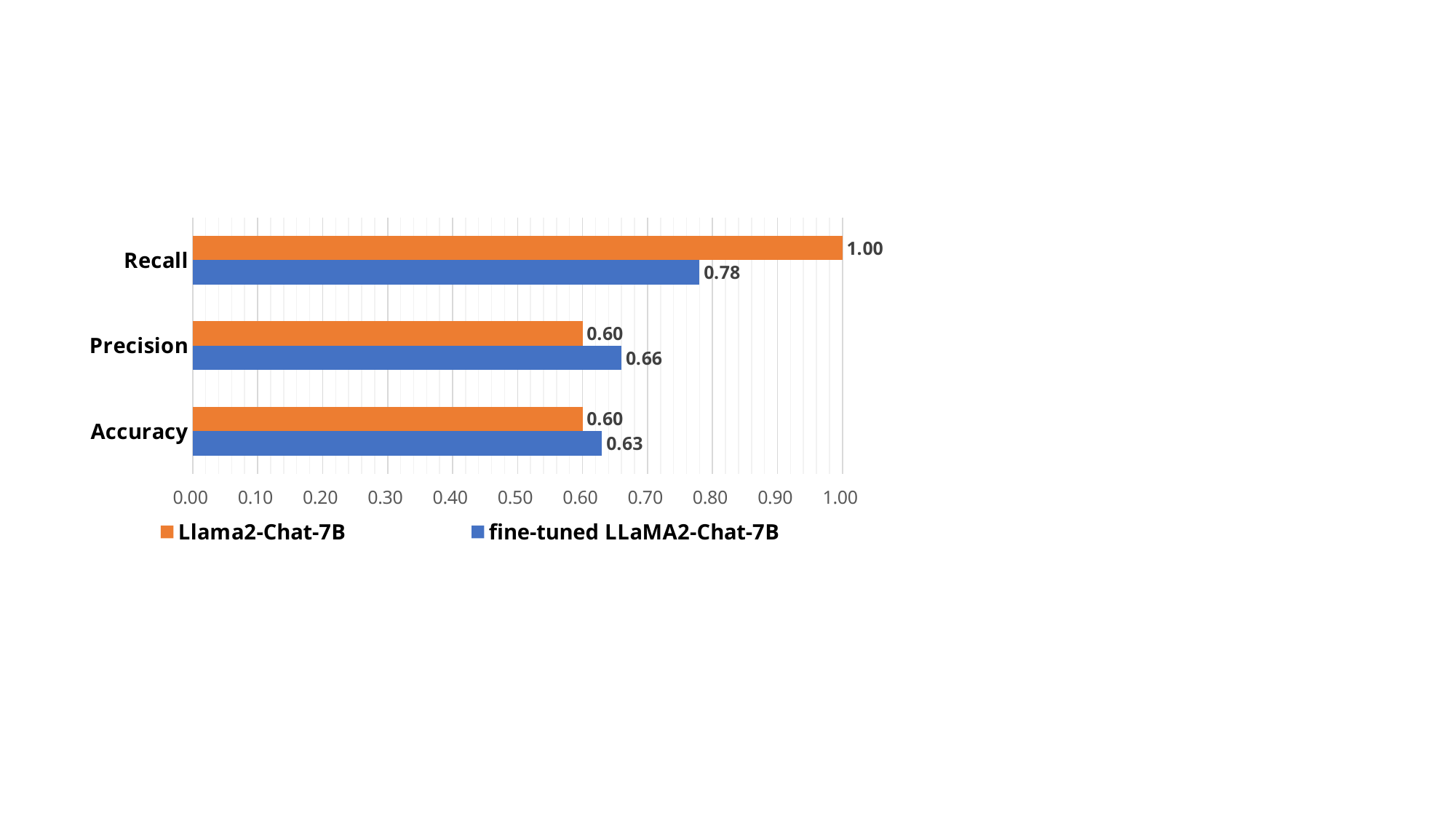
Which metric has the highest value for fine-tuned LLaMA2-Chat-7B? Recall What is the difference between the Recall values of Llama2-Chat-7B and fine-tuned LLaMA2-Chat-7B? 0.22 Which model has the higher Precision value? fine-tuned LLaMA2-Chat-7B What is the Accuracy value for Llama2-Chat-7B? 0.60 What is the Precision value for fine-tuned LLaMA2-Chat-7B? 0.66 What kind of chart is shown on the slide? Bar chart What is the Recall value for fine-tuned LLaMA2-Chat-7B? 0.78 Is the Recall value for fine-tuned LLaMA2-Chat-7B greater or less than 0.70? greater What is the Recall value for Llama2-Chat-7B? 1.00 Which metric has the lowest value for fine-tuned LLaMA2-Chat-7B? Accuracy How many series does the legend list? 2 How many metrics (categories) are shown on the chart? 3